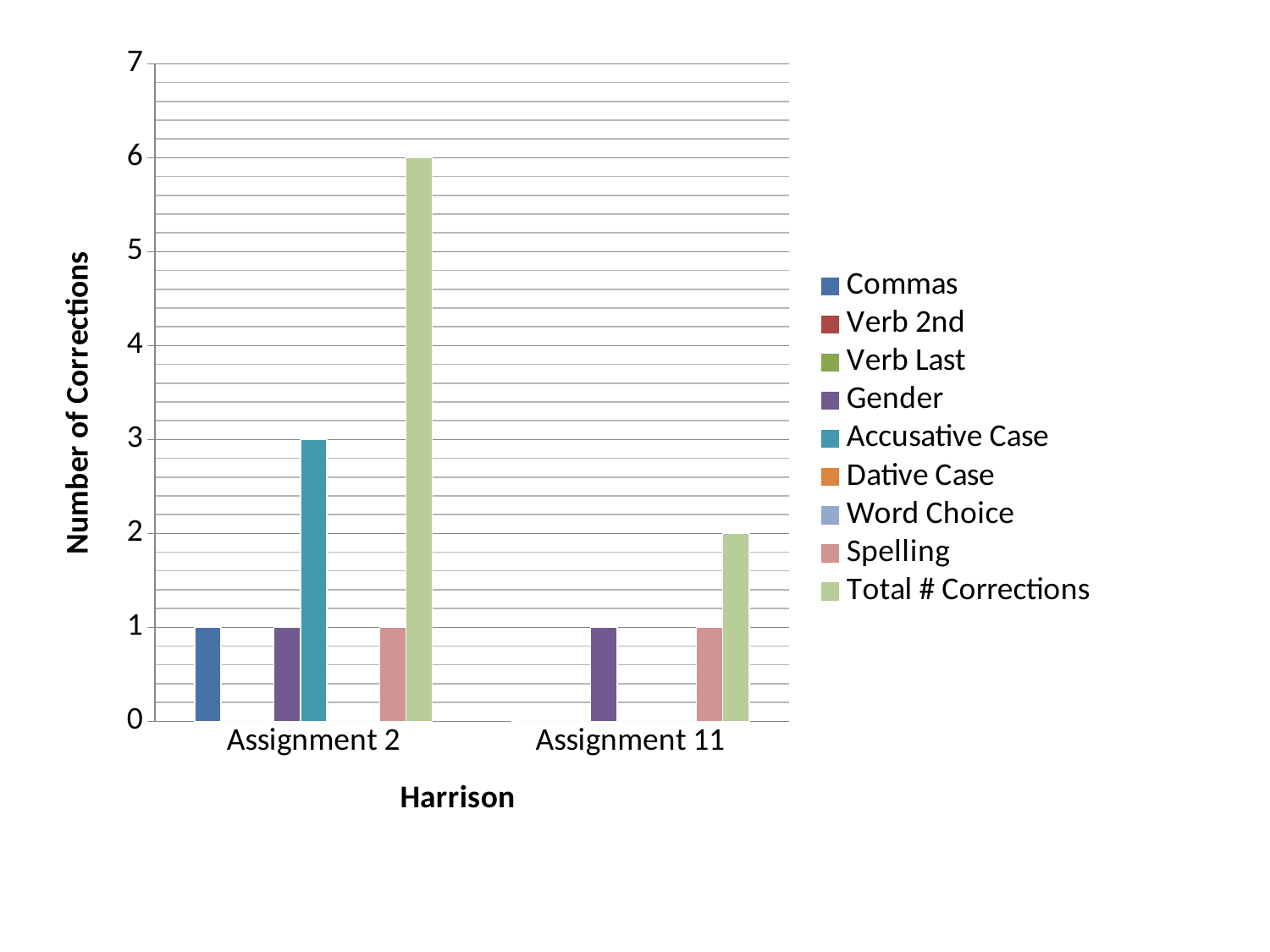
Which assignment has the higher Total # Corrections? Assignment 2 What is the difference in Total # Corrections between Assignment 2 and Assignment 11? 4 Excluding Total # Corrections, which correction type has the highest value for Assignment 2? Accusative Case What is the Total # Corrections value for Assignment 2? 6 How many Spelling corrections are shown for Assignment 11? 1 What is the label of the y axis? Number of Corrections Does the Total # Corrections rise or fall from Assignment 2 to Assignment 11? fall How many assignment categories are shown on the x axis? 2 What kind of chart is shown on the slide? bar chart What is the Total # Corrections value for Assignment 11? 2 How many series does the legend list? 9 How many Accusative Case corrections are shown for Assignment 2? 3